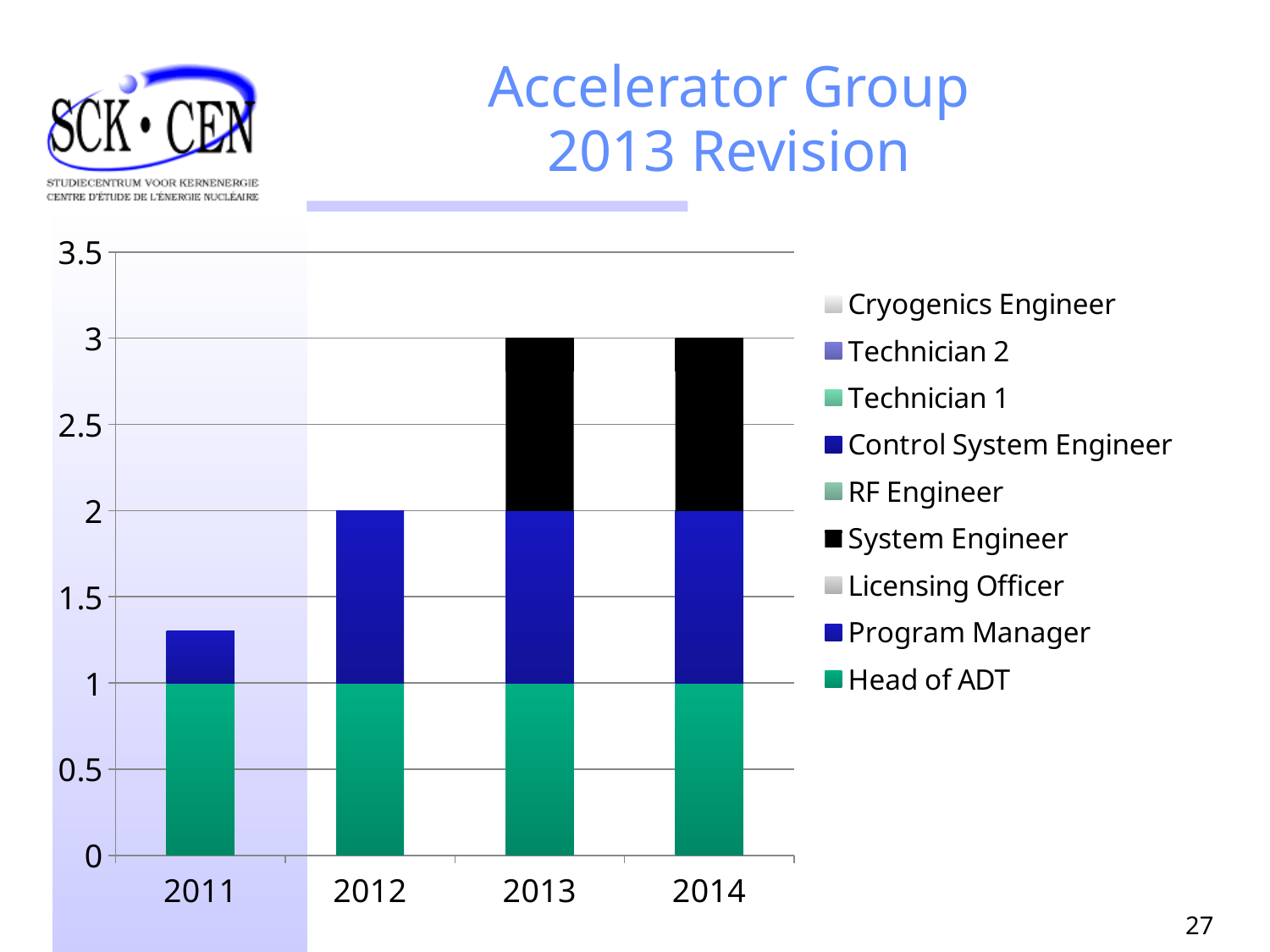
What is the total height of the stacked bar for 2012? 2 Is the total value for 2011 greater or less than 1.5? less Is the total value for 2011 greater or less than 1? greater What is the value of the Head of ADT segment in 2012? 1 How many years are shown on the x axis of the chart? 4 What is the total height of the stacked bar for 2013? 3 How many series does the chart's legend list? 9 What colour represents System Engineer in the chart? Black Do the total bar heights rise or fall from 2011 to 2014? Rise Which year has the lowest total bar? 2011 Which year has the larger total bar, 2012 or 2013? 2013 What kind of chart is shown on the slide? Stacked bar chart